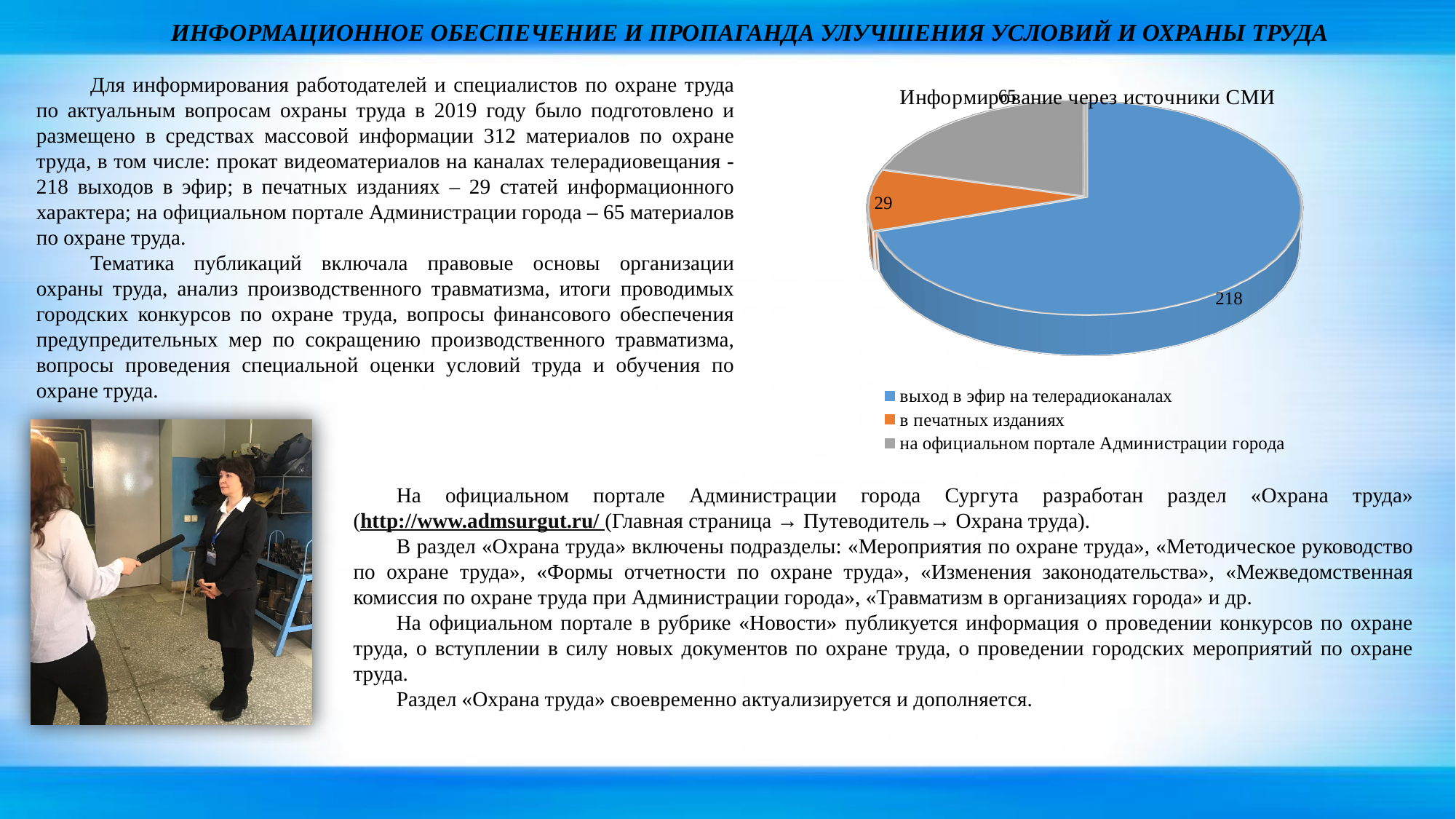
Which is larger: the value for "на официальном портале Администрации города" or the value for "в печатных изданиях"? на официальном портале Администрации города Which category has the largest slice of the pie? выход в эфир на телерадиоканалах What is the value for "выход в эфир на телерадиоканалах"? 218 What is the total of all three slices in the pie chart? 312 What kind of chart is shown on the slide? Pie chart What is the value for "на официальном портале Администрации города"? 65 How many slices does the pie chart have? 3 What is the difference between the values for "выход в эфир на телерадиоканалах" and "на официальном портале Администрации города"? 153 Which category has the smallest slice of the pie? в печатных изданиях What is the value for "в печатных изданиях"? 29 What is the title of the chart? Информирование через источники СМИ How many entries does the chart legend list? 3